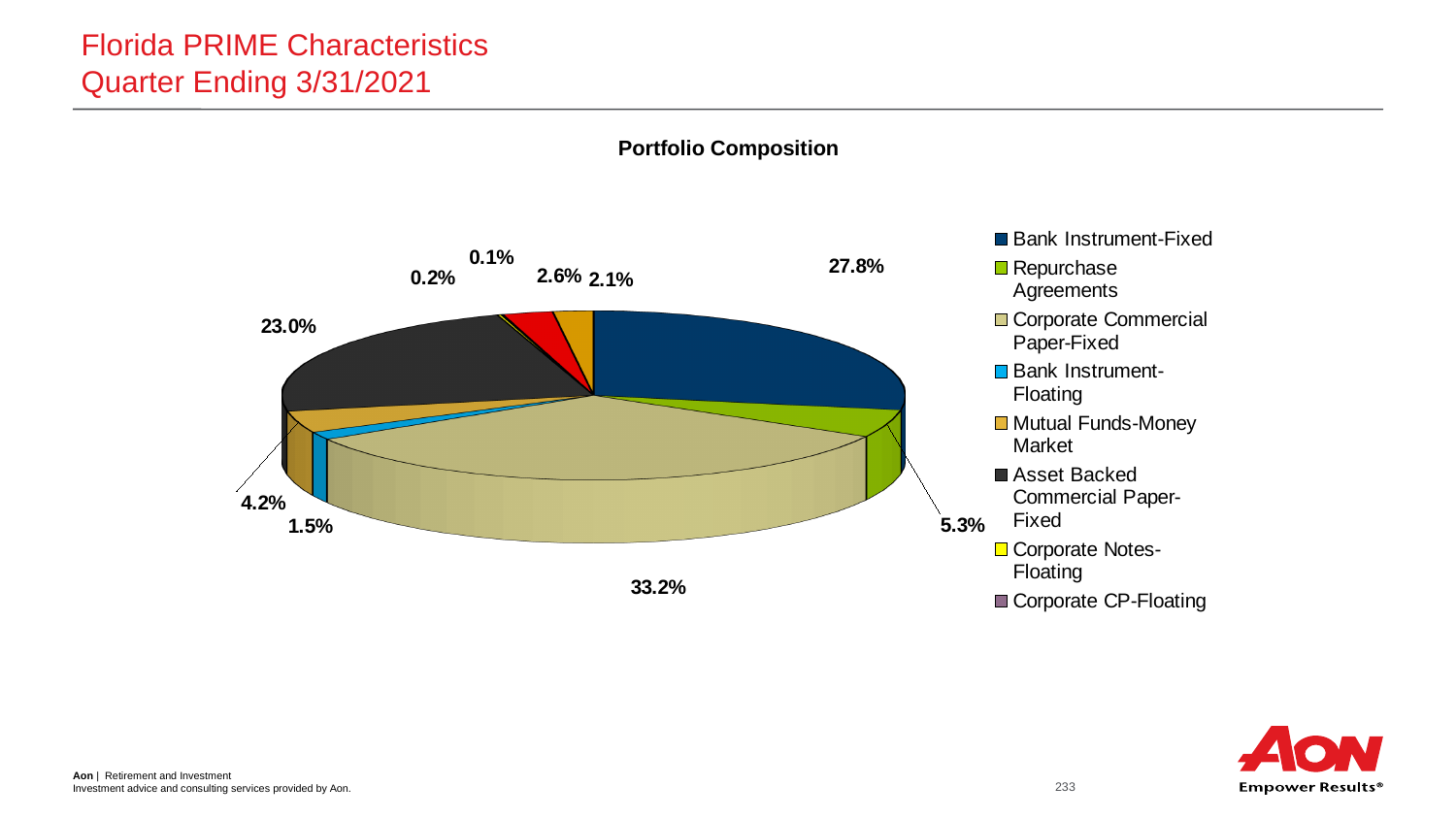
What share of the portfolio is Bank Instrument-Fixed? 27.8% Which is larger: Bank Instrument-Fixed or Asset Backed Commercial Paper-Fixed? Bank Instrument-Fixed What is the value for Bank Instrument-Floating? 1.5% How many percentage points larger is Corporate Commercial Paper-Fixed than Bank Instrument-Fixed? 5.4 percentage points Which category makes up the largest share of the portfolio? Corporate Commercial Paper-Fixed What is the smallest percentage labeled on the pie chart? 0.1% How many categories does the legend list? 8 What type of chart is used to show the portfolio composition? Pie chart What percentage is shown for Asset Backed Commercial Paper-Fixed? 23.0% What percentage of the portfolio is in Repurchase Agreements? 5.3% What percentage of the portfolio is Corporate Commercial Paper-Fixed? 33.2% What percentage is Mutual Funds-Money Market? 4.2%